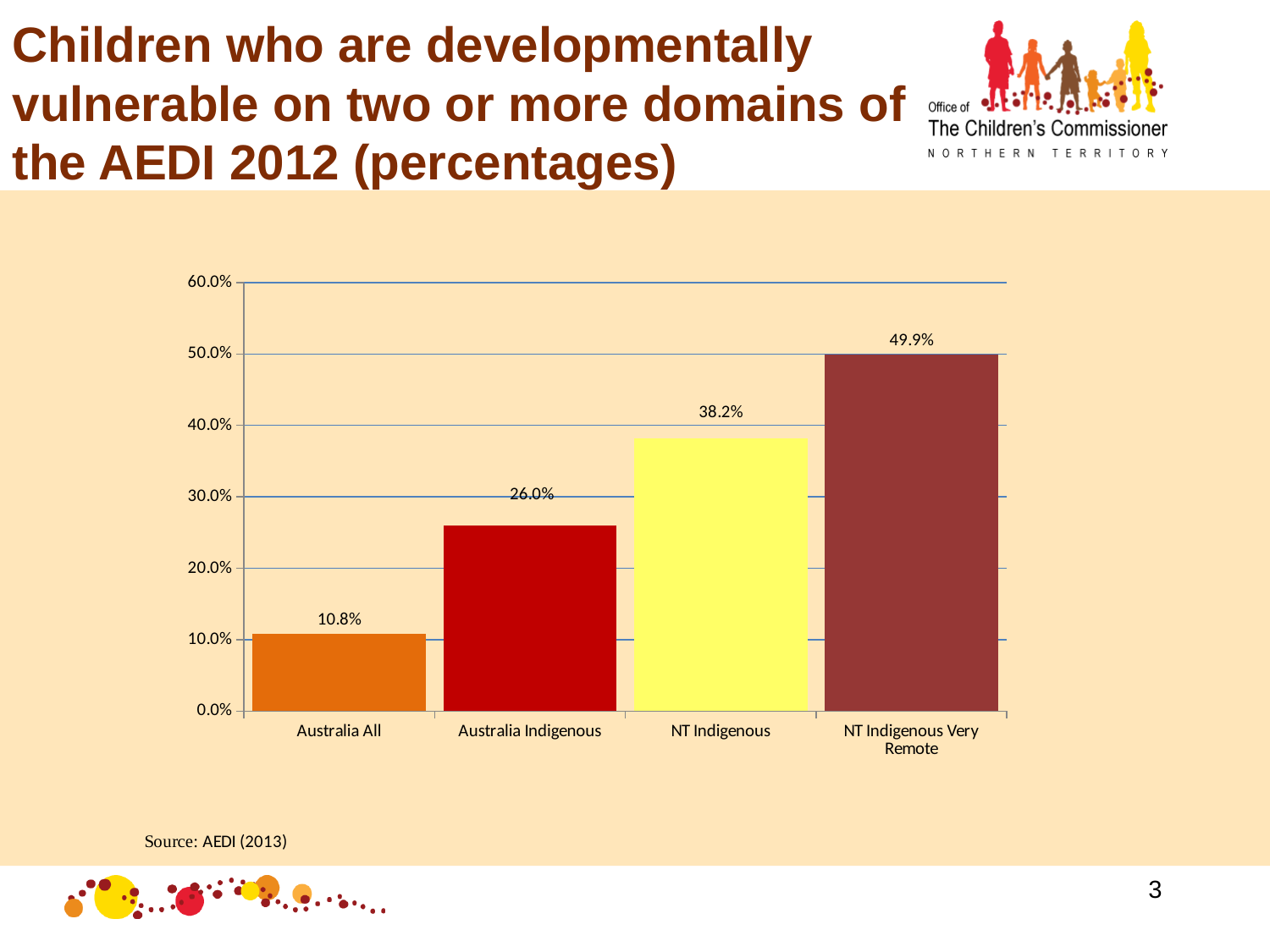
What is the difference between the values for NT Indigenous and Australia Indigenous? 12.2% Which is larger, the value for NT Indigenous or the value for Australia Indigenous? NT Indigenous What is the value for Australia Indigenous? 26.0% Is the value for NT Indigenous greater or less than 30.0%? greater Which category has the lowest value? Australia All Do the values rise or fall from left to right across the categories? rise What is the value for NT Indigenous Very Remote? 49.9% What is the value for Australia All? 10.8% Which category has the highest value? NT Indigenous Very Remote What kind of chart is shown on the slide? bar chart How many categories are shown on the chart? 4 What is the difference between the values for NT Indigenous Very Remote and Australia All? 39.1%